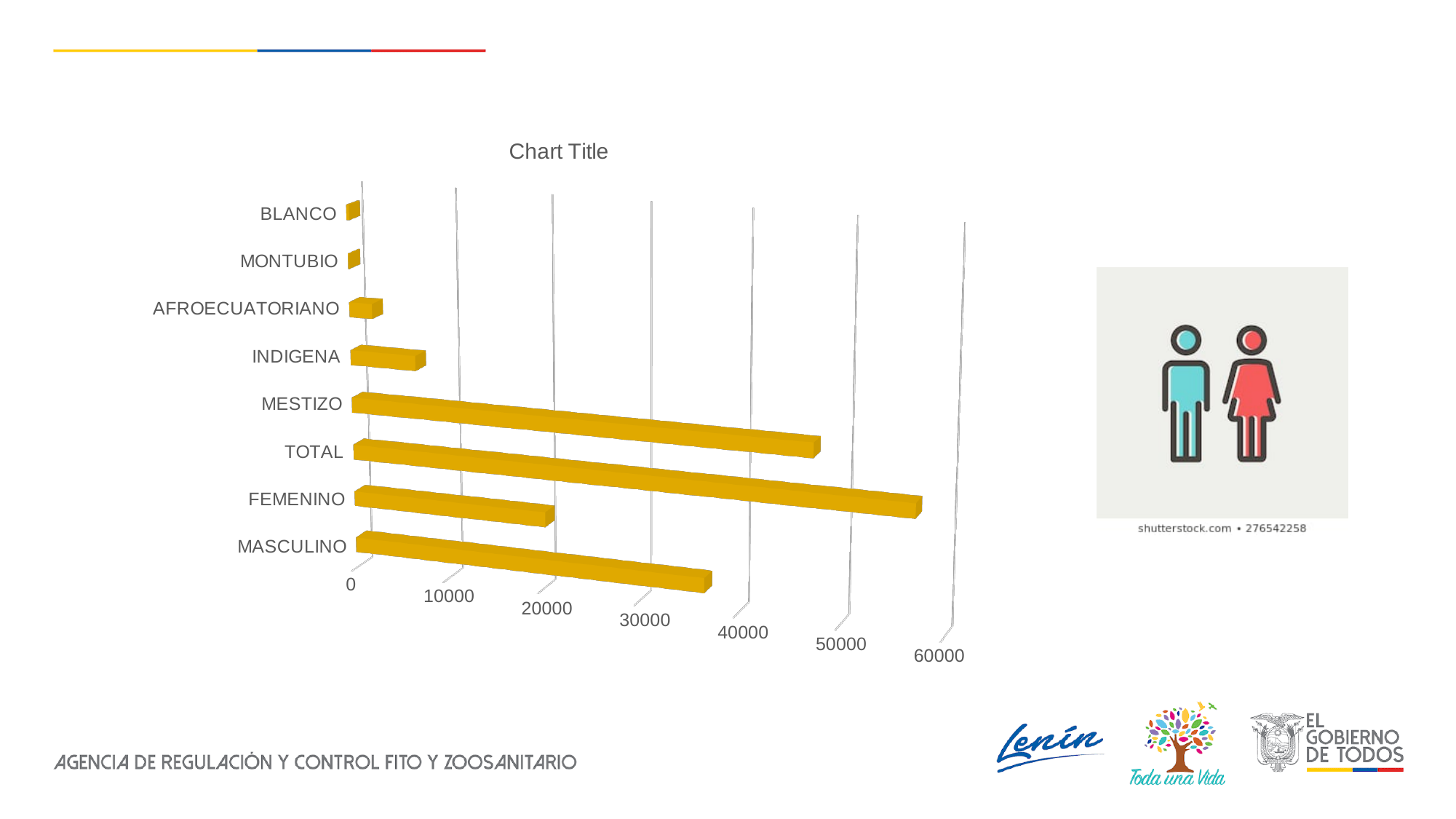
Is the value for MESTIZO greater or less than 40000? greater Which is larger, the value for MASCULINO or the value for FEMENINO? MASCULINO Is the value for TOTAL greater or less than 50000? greater Which is larger, the value for MESTIZO or the value for INDIGENA? MESTIZO Is the value for FEMENINO greater or less than 30000? less How many categories are plotted on the chart? 8 Which category has the highest value on the chart? TOTAL What is the title shown above the chart? Chart Title What kind of chart is shown on the slide? bar chart